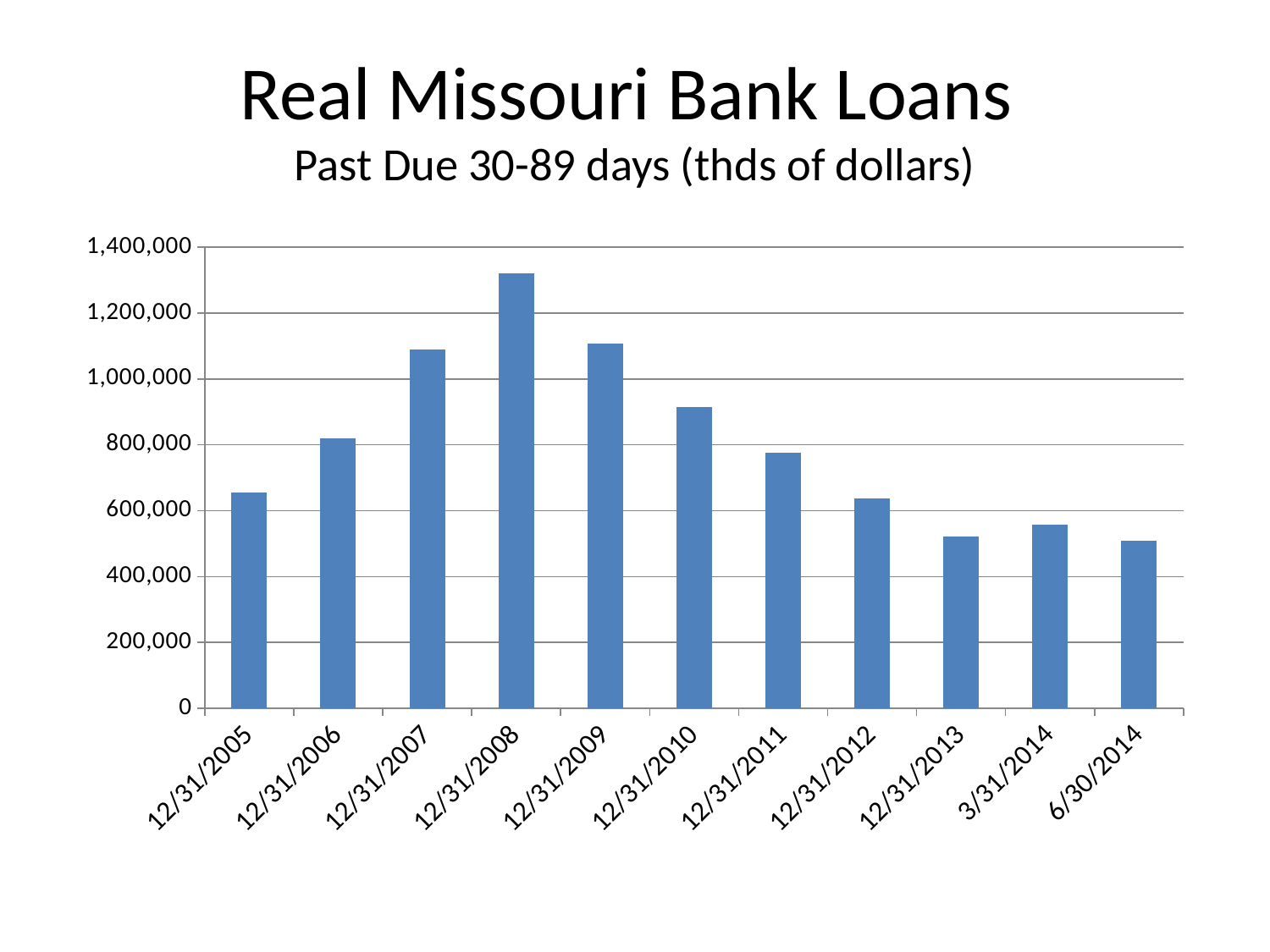
Do the values rise or fall from 12/31/2008 to 12/31/2013? fall What kind of chart is shown on the slide? bar chart Is the value for 12/31/2008 greater or less than 1,200,000? greater Which is larger, the value for 12/31/2006 or the value for 12/31/2010? 12/31/2010 Is the value for 12/31/2013 greater or less than 600,000? less Which is larger, the value for 12/31/2011 or the value for 12/31/2012? 12/31/2011 How many dates (bars) are plotted on the chart? 11 Is the value for 12/31/2007 greater or less than 1,000,000? greater What is the title of the chart on the slide? Real Missouri Bank Loans Past Due 30-89 days (thds of dollars) Which date has the highest value of past due loans? 12/31/2008